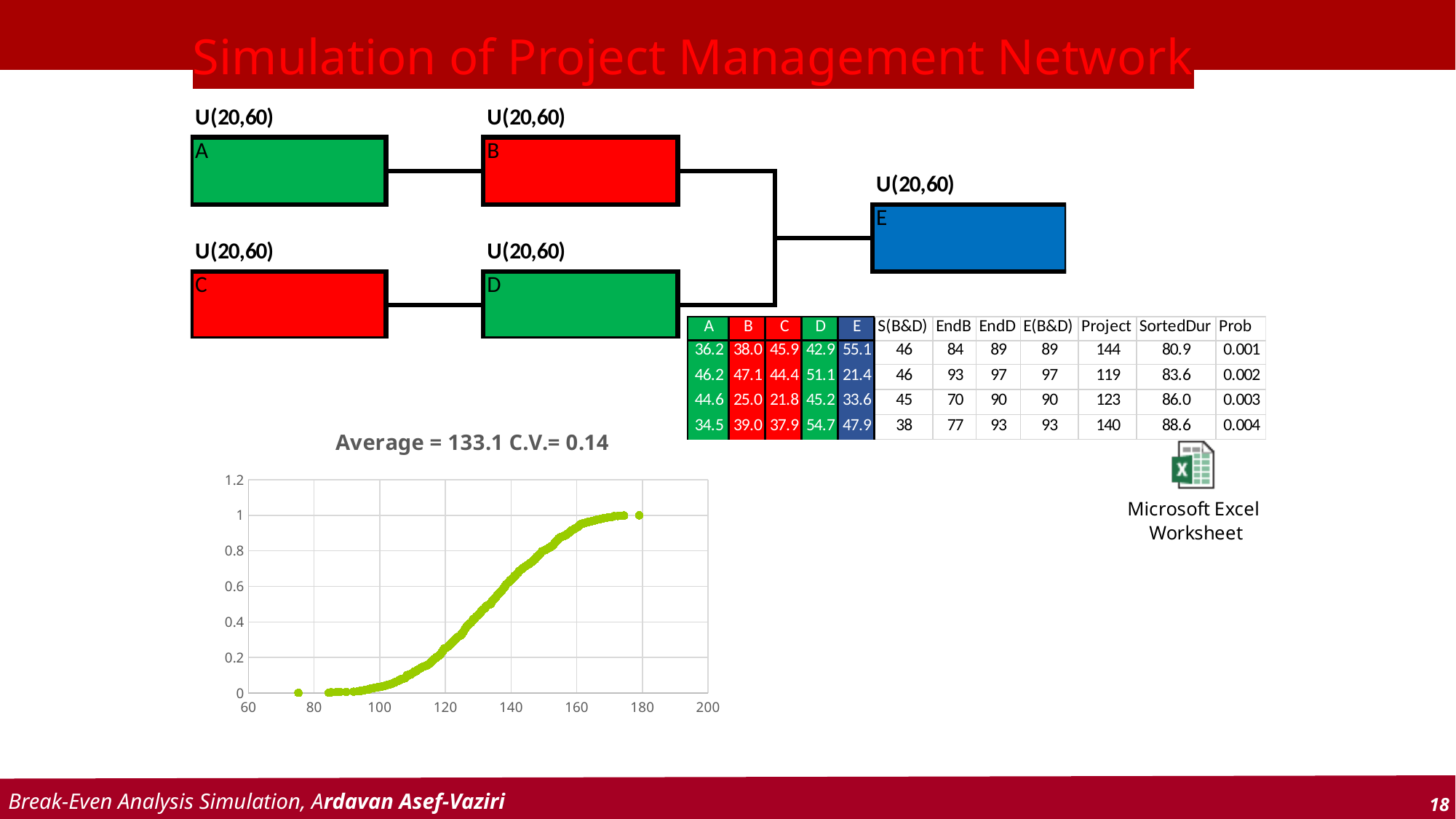
Is the plotted value at x = 160 greater or less than 0.8? greater What value do the plotted points level off at near the right end of the chart? 1 What kind of chart is shown on the slide? scatter chart What is the title of the chart? Average = 133.1 C.V.= 0.14 What is the highest value shown on the chart's y axis? 1.2 Do the plotted values rise or fall as the x axis increases from 80 to 180? rise Is the plotted value at x = 140 greater or less than 0.4? greater Is the plotted value at x = 120 greater or less than 0.4? less What is the lowest value shown on the chart's x axis? 60 What is the highest value shown on the chart's x axis? 200